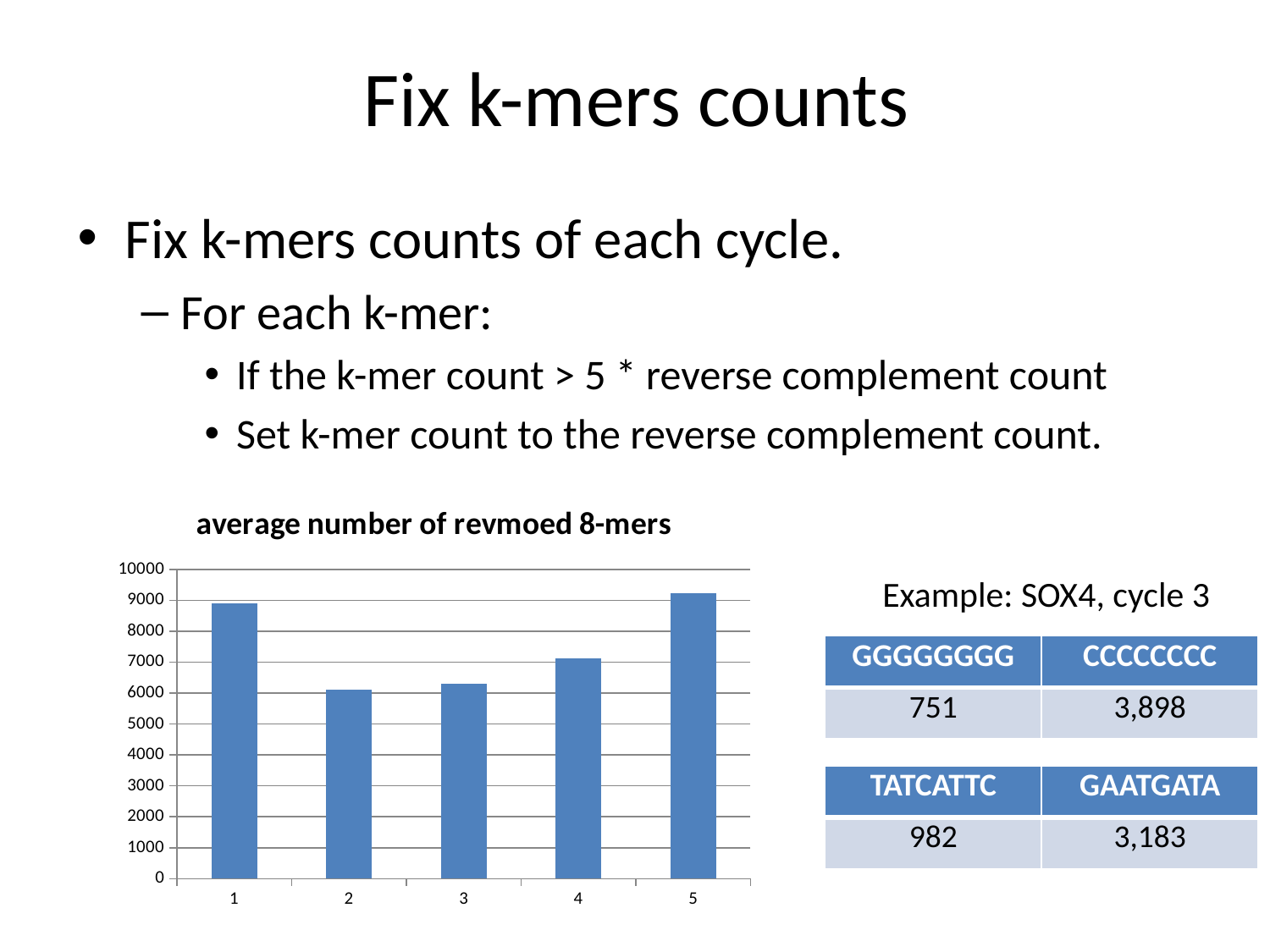
Which is larger, the value for category 1 or the value for category 5? 5 Is the value for category 2 greater or less than 7000? less What type of chart is shown on the slide? bar chart What is the title of the chart? average number of revmoed 8-mers How many categories are plotted on the x axis of the chart? 5 Which category has the highest bar in the chart? 5 Is the value for category 5 greater or less than 9000? greater Which is larger, the value for category 2 or the value for category 4? 4 Is the value for category 1 greater or less than 8000? greater Do the values rise or fall from category 1 to category 2? fall Do the values rise or fall from category 3 to category 5? rise